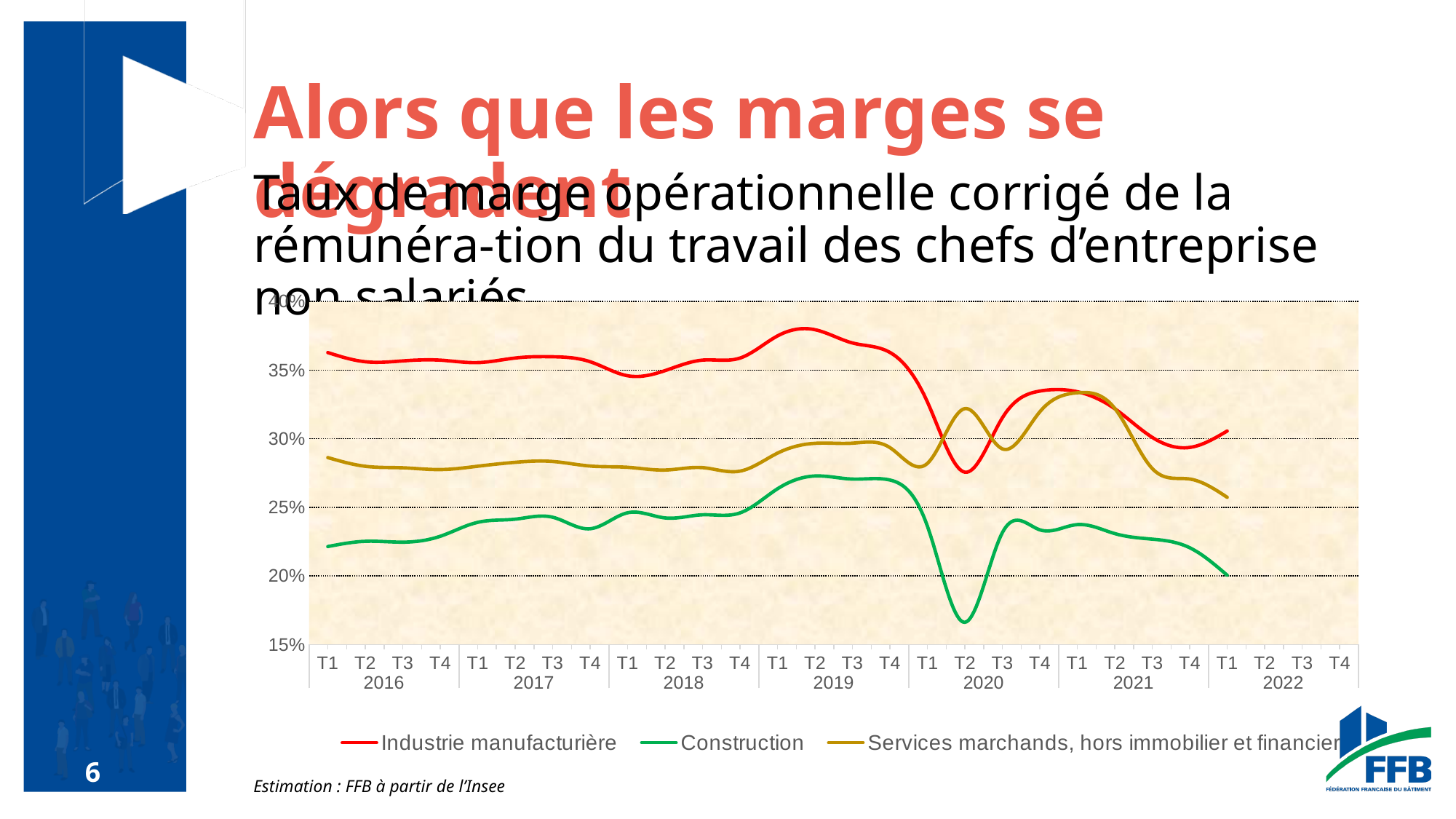
Does the Construction line rise or fall from T1 2021 to T1 2022? fall Which series has the highest value in T1 2016? Industrie manufacturière Which series has the lowest value in T1 2016? Construction Is the value for Construction in T2 2020 greater or less than 20%? less Is the value for Industrie manufacturière in T2 2019 greater or less than 35%? greater How many series does the legend list? 3 How many years are labelled along the x axis? 7 Which series is shown in green in the legend? Construction In T2 2020, which is higher: Industrie manufacturière or Services marchands, hors immobilier et financier? Services marchands, hors immobilier et financier Is the value for Services marchands, hors immobilier et financier in T1 2016 greater or less than 30%? less What kind of chart is shown on the slide? line chart